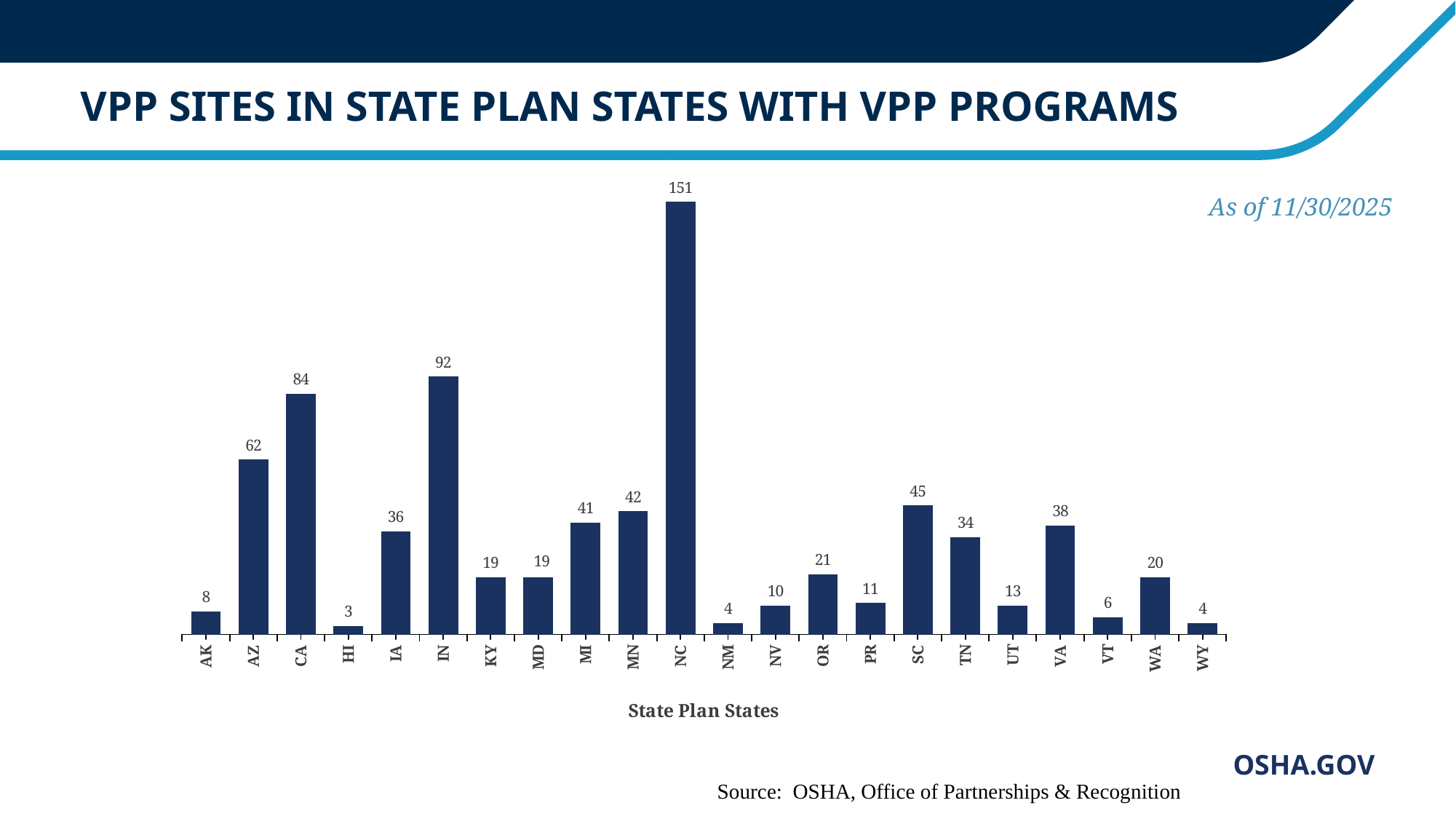
What is the value shown for SC? 45 How many states are shown on the x axis? 22 What is the difference between the values for NC and IN? 59 What is the value shown for IN? 92 Which state has the lowest number of VPP sites? HI Which state has the highest number of VPP sites? NC Which has a larger value, OR or WA? OR Which has a larger value, VA or TN? VA How many VPP sites does NC have? 151 What is the difference between the values for CA and AZ? 22 What kind of chart is shown on the slide? Bar chart What is the x-axis title of the chart? State Plan States